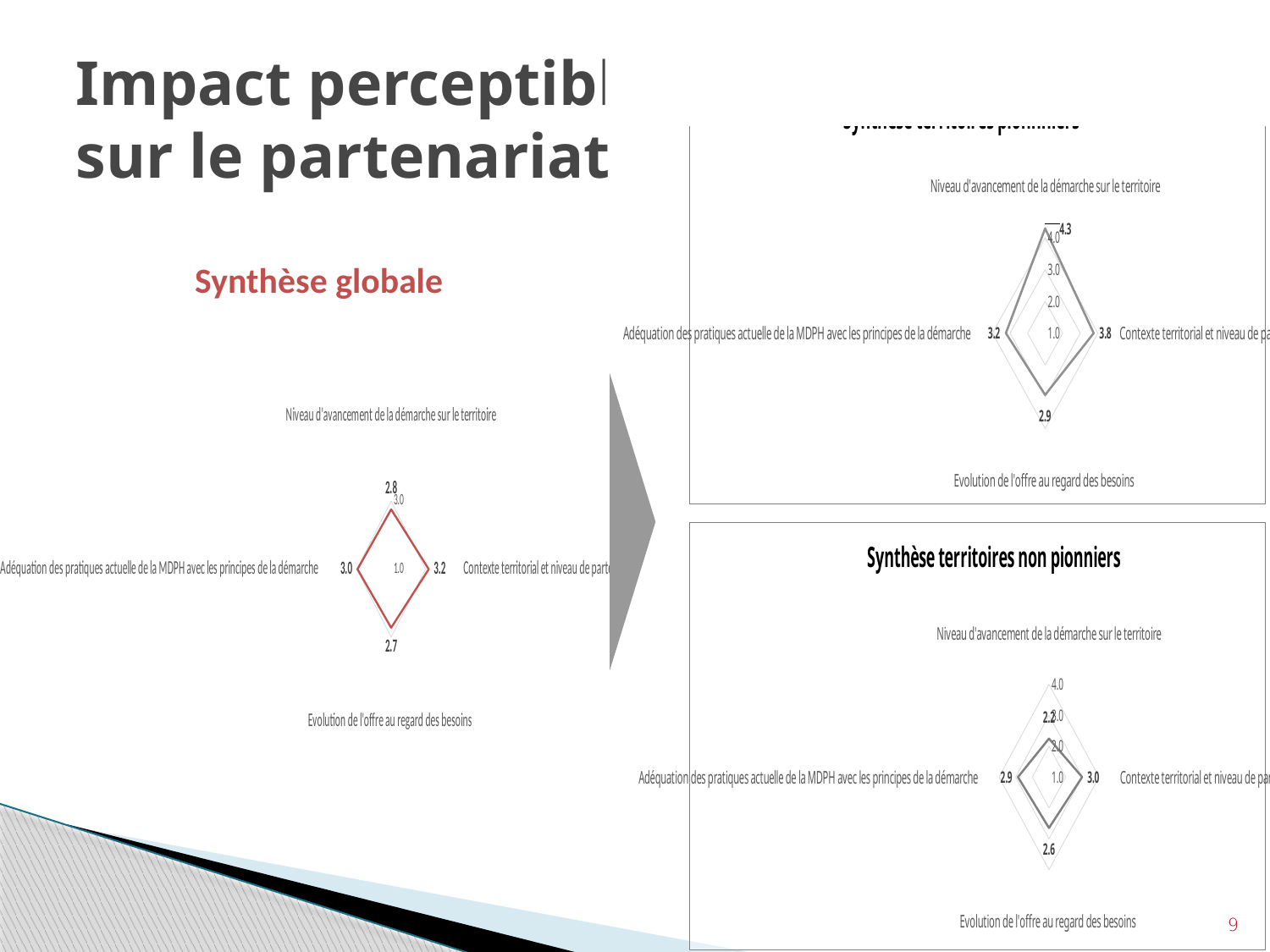
On the Synthèse territoires non pionniers chart, which is larger: the value for Adéquation des pratiques actuelle de la MDPH or the value for Evolution de l'offre au regard des besoins? Adéquation des pratiques actuelle de la MDPH What kind of chart is the Synthèse globale chart? Radar chart On the top right chart, what is the difference between the value for Niveau d'avancement de la démarche sur le territoire and the value for Contexte territorial? 0.5 On the top right chart, which axis has the lowest value? Evolution de l'offre au regard des besoins On the Synthèse territoires non pionniers chart, what is the value for Contexte territorial? 3.0 On the Synthèse globale chart, which axis has the highest value? Contexte territorial et niveau de partenariat On the Synthèse globale chart, what is the value for Niveau d'avancement de la démarche sur le territoire? 2.8 How many axes (categories) does the Synthèse territoires non pionniers chart have? 4 On the Synthèse globale chart, what is the difference between the value for Adéquation des pratiques actuelle de la MDPH avec les principes de la démarche and the value for Evolution de l'offre au regard des besoins? 0.3 On the Synthèse territoires non pionniers chart, what is the value for Niveau d'avancement de la démarche sur le territoire? 2.2 On the Synthèse globale chart, what is the value for Evolution de l'offre au regard des besoins? 2.7 On the top right chart, what is the value for Niveau d'avancement de la démarche sur le territoire? 4.3